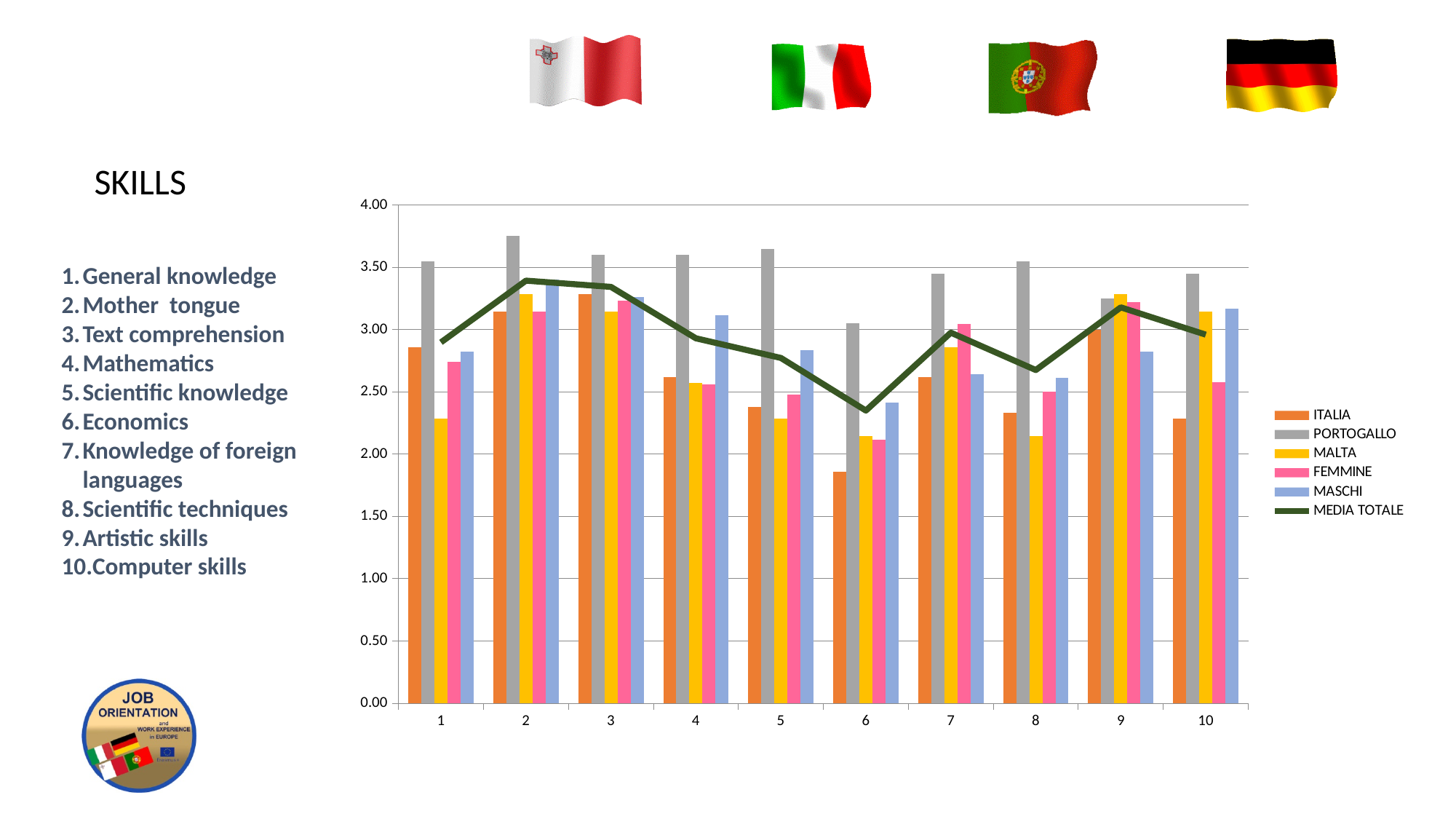
Is the PORTOGALLO value for category 1 greater or less than 3.00? greater For category 10, which is larger: the MALTA bar or the FEMMINE bar? MALTA How many categories are shown on the x axis of the chart? 10 How many series does the legend list? 6 Is the MALTA value for category 1 greater or less than 2.50? less Is the ITALIA value for category 6 greater or less than 2.00? less At which category does the MEDIA TOTALE line reach its lowest point? 6 What kind of chart is shown on the slide? combination bar and line chart For category 6, which is larger: the ITALIA bar or the MASCHI bar? MASCHI Which series is drawn as a line rather than bars? MEDIA TOTALE For which category is the PORTOGALLO bar the highest? 2 For which category is the ITALIA bar the lowest? 6